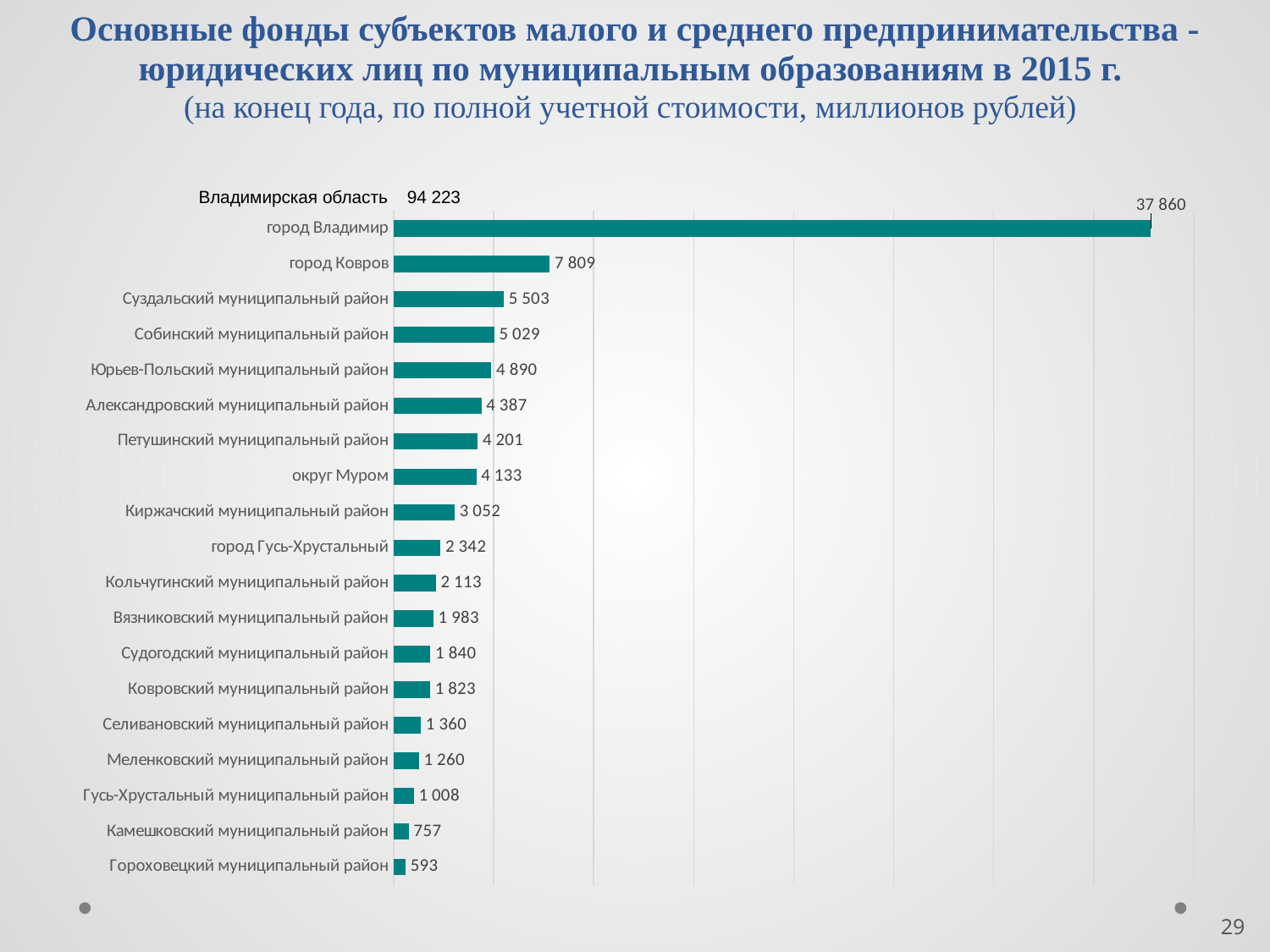
How many municipalities are shown as bars in the chart? 19 What value is shown for Владимирская область above the chart? 94 223 What is the difference between the values for Камешковский муниципальный район and Гороховецкий муниципальный район? 164 What is the value for Гороховецкий муниципальный район? 593 Which municipality has the lowest value? Гороховецкий муниципальный район What type of chart is shown on the slide? bar chart What is the value for город Владимир? 37 860 What is the value for Суздальский муниципальный район? 5 503 What is the difference between the values for город Ковров and Суздальский муниципальный район? 2 306 Which is larger, the value for Петушинский муниципальный район or Киржачский муниципальный район? Петушинский муниципальный район Which municipality has the highest value? город Владимир What is the value for округ Муром? 4 133